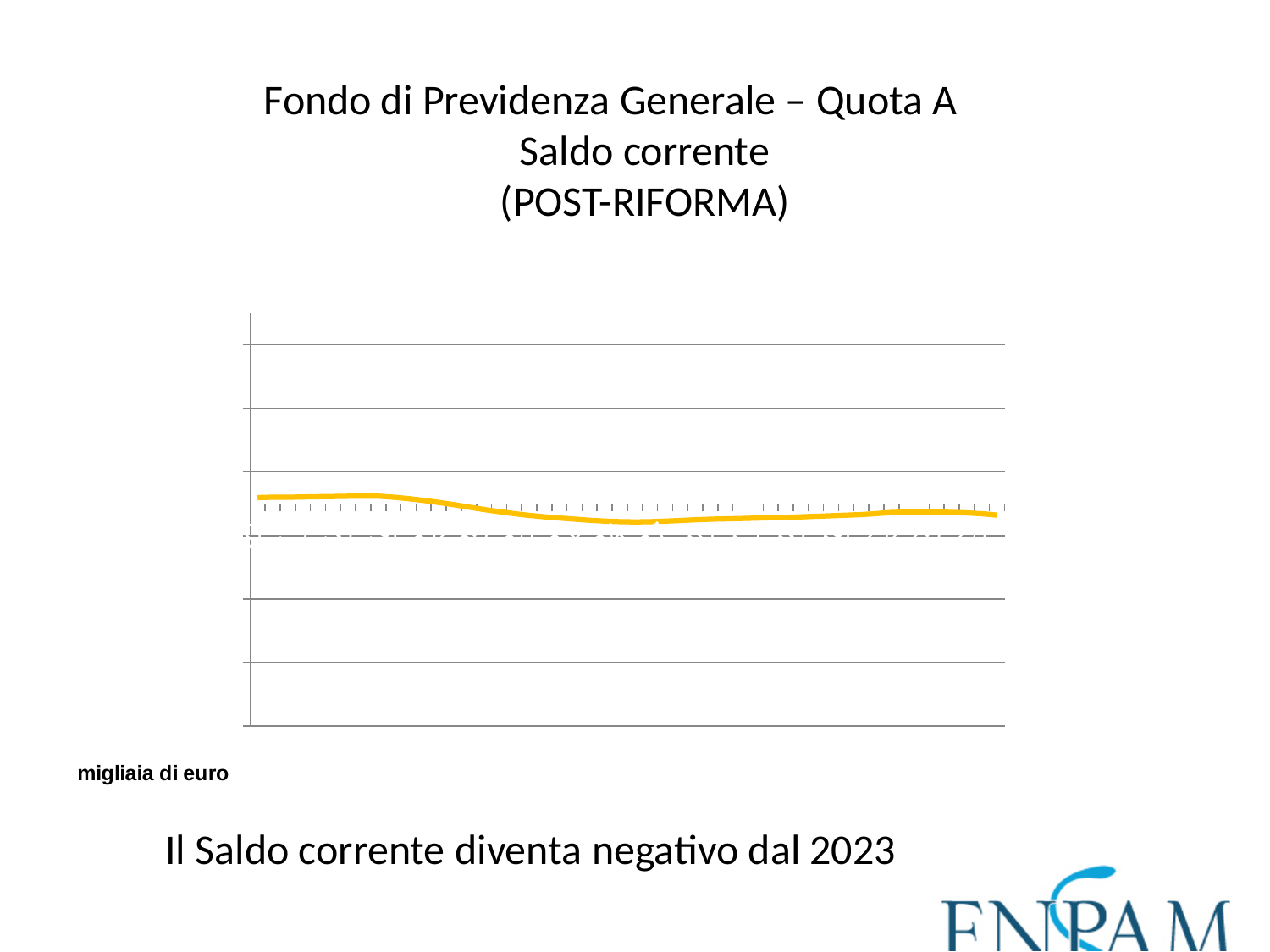
Is the plotted line higher at its left end or at its right end? left end What is the title of the chart on the slide? Fondo di Previdenza Generale – Quota A Saldo corrente (POST-RIFORMA) How many lines are plotted in the chart? 1 What colour is the plotted line in the chart? yellow Does the plotted line rise or fall from its left end to its lowest point near the middle of the chart? fall What kind of chart is shown on the slide? line chart